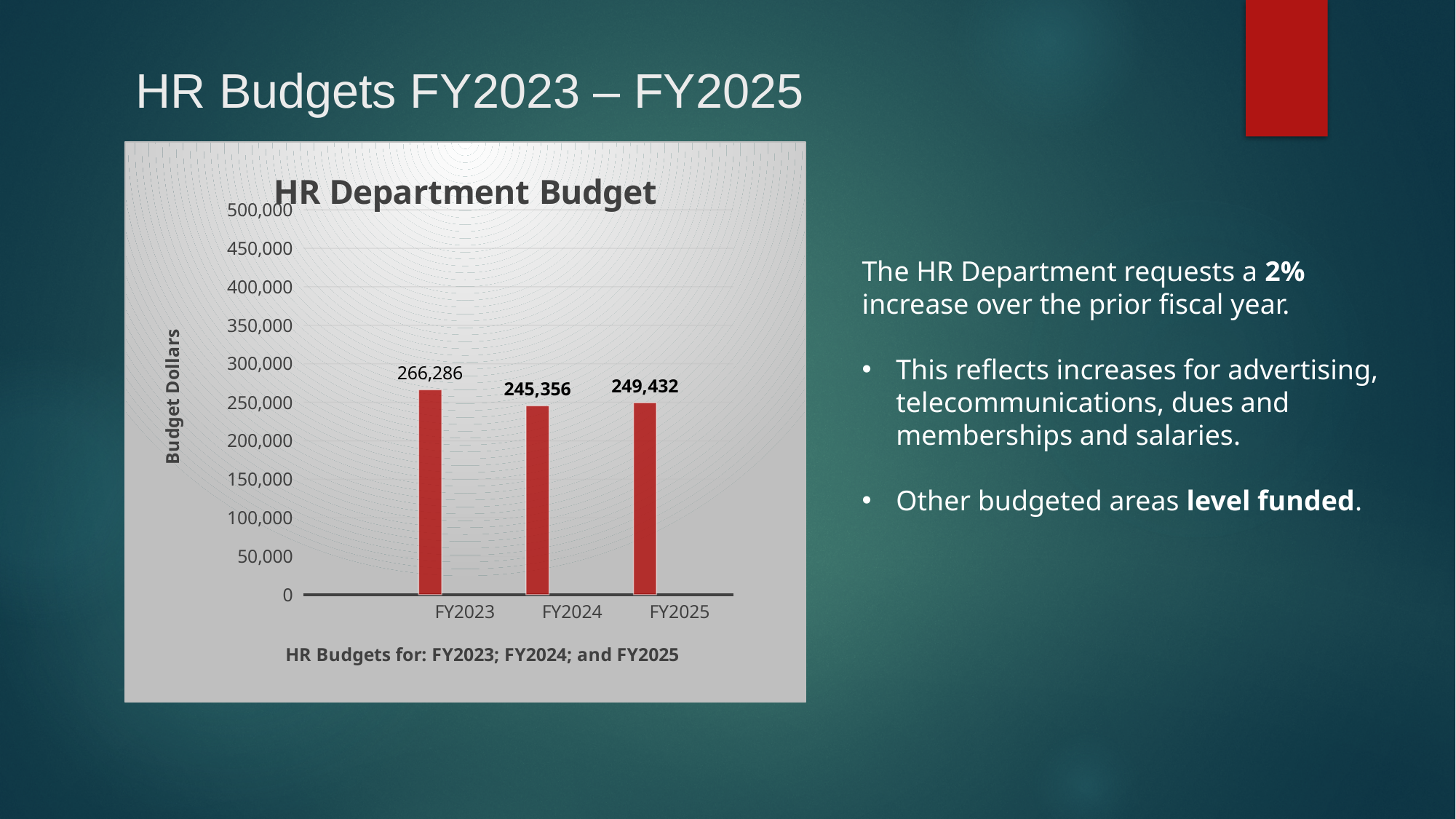
What kind of chart is the HR Department Budget chart? bar chart What is the label on the vertical axis of the HR Department Budget chart? Budget Dollars What is the difference between the FY2023 and FY2024 HR Department Budget values? 20,930 Is the HR Department Budget for FY2024 greater or less than 250,000? less What is the difference between the FY2025 and FY2024 HR Department Budget values? 4,076 What is the HR Department Budget value for FY2024? 245,356 How many fiscal years are shown in the HR Department Budget chart? 3 Which is larger, the HR Department Budget for FY2023 or FY2025? FY2023 Which fiscal year has the highest HR Department Budget? FY2023 Which fiscal year has the lowest HR Department Budget? FY2024 What is the HR Department Budget value for FY2025? 249,432 What is the HR Department Budget value for FY2023? 266,286